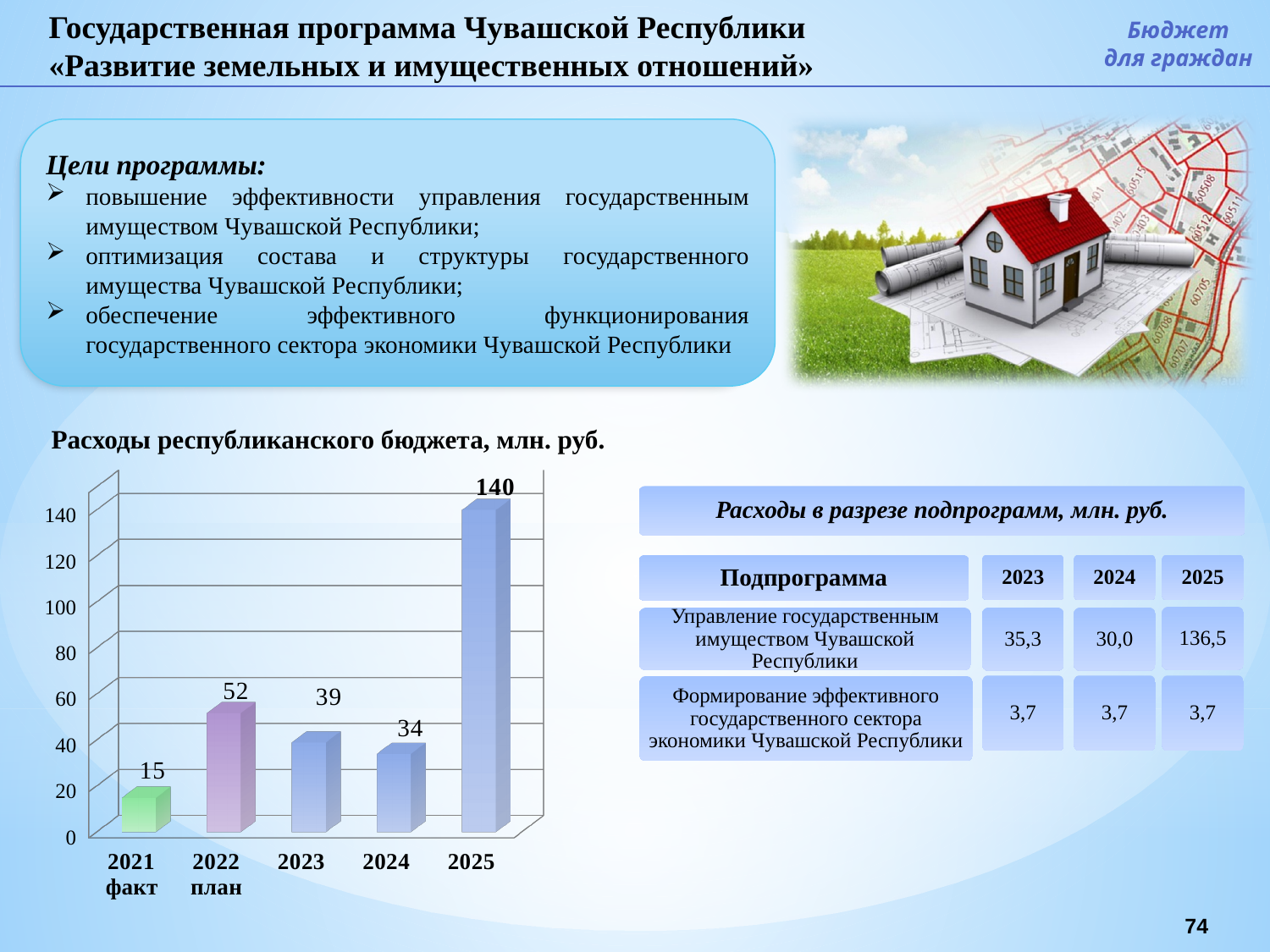
What is the difference between the values for 2025 and 2024 in the bar chart? 106 Which year has the highest value in the bar chart? 2025 What is the value for 2025 in the bar chart of republican budget expenditures? 140 What kind of chart is used to show the republican budget expenditures? bar chart Is the value for 2024 in the bar chart greater or less than 40? less Which is larger in the bar chart, the value for 2022 план or the value for 2023? 2022 план What is the difference between the values for 2022 план and 2021 факт in the bar chart? 37 How many bars are shown in the bar chart? 5 What is the value for 2023 in the bar chart? 39 Which year has the lowest value in the bar chart? 2021 факт What is the title of the chart on the slide? Расходы республиканского бюджета, млн. руб. What is the value for 2021 факт in the bar chart? 15